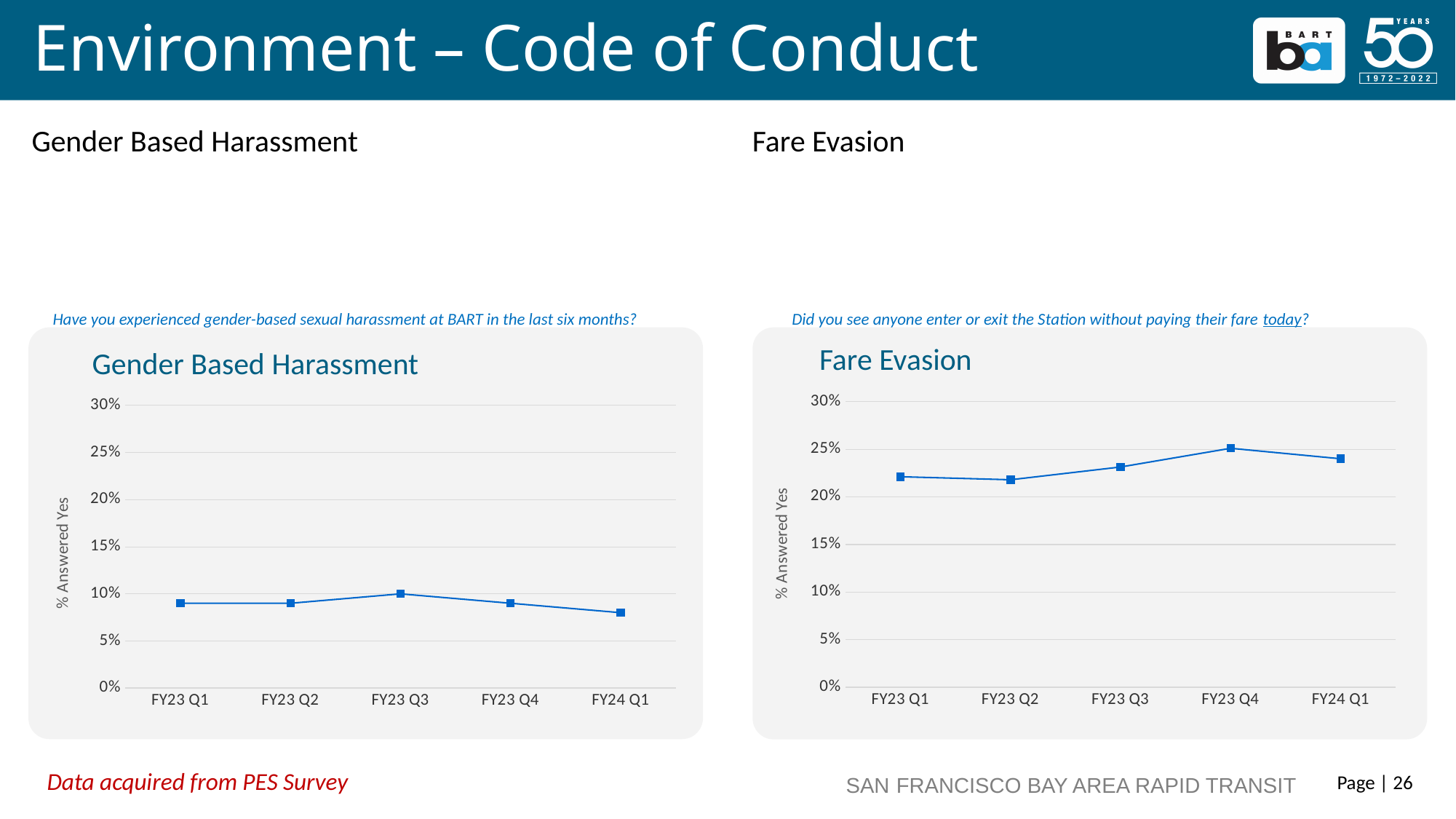
In the Fare Evasion chart, which is larger, the value for FY23 Q4 or the value for FY23 Q1? FY23 Q4 What is the y-axis label on the Fare Evasion chart? % Answered Yes In the Fare Evasion chart, which quarter has the highest percentage answering yes? FY23 Q4 In the Gender Based Harassment chart, which quarter has the highest percentage answering yes? FY23 Q3 In the Fare Evasion chart, do the values rise or fall from FY23 Q2 to FY23 Q4? rise What kind of chart is the Gender Based Harassment chart? line chart In the Fare Evasion chart, is the value for FY23 Q1 greater or less than 20%? greater In the Gender Based Harassment chart, which quarter has the lowest percentage answering yes? FY24 Q1 In the Gender Based Harassment chart, what is the value for FY23 Q3? 10% How many quarters are plotted in the Gender Based Harassment chart? 5 In the Fare Evasion chart, is the value for FY23 Q2 greater or less than 25%? less In the Gender Based Harassment chart, is the value for FY24 Q1 greater or less than 10%? less